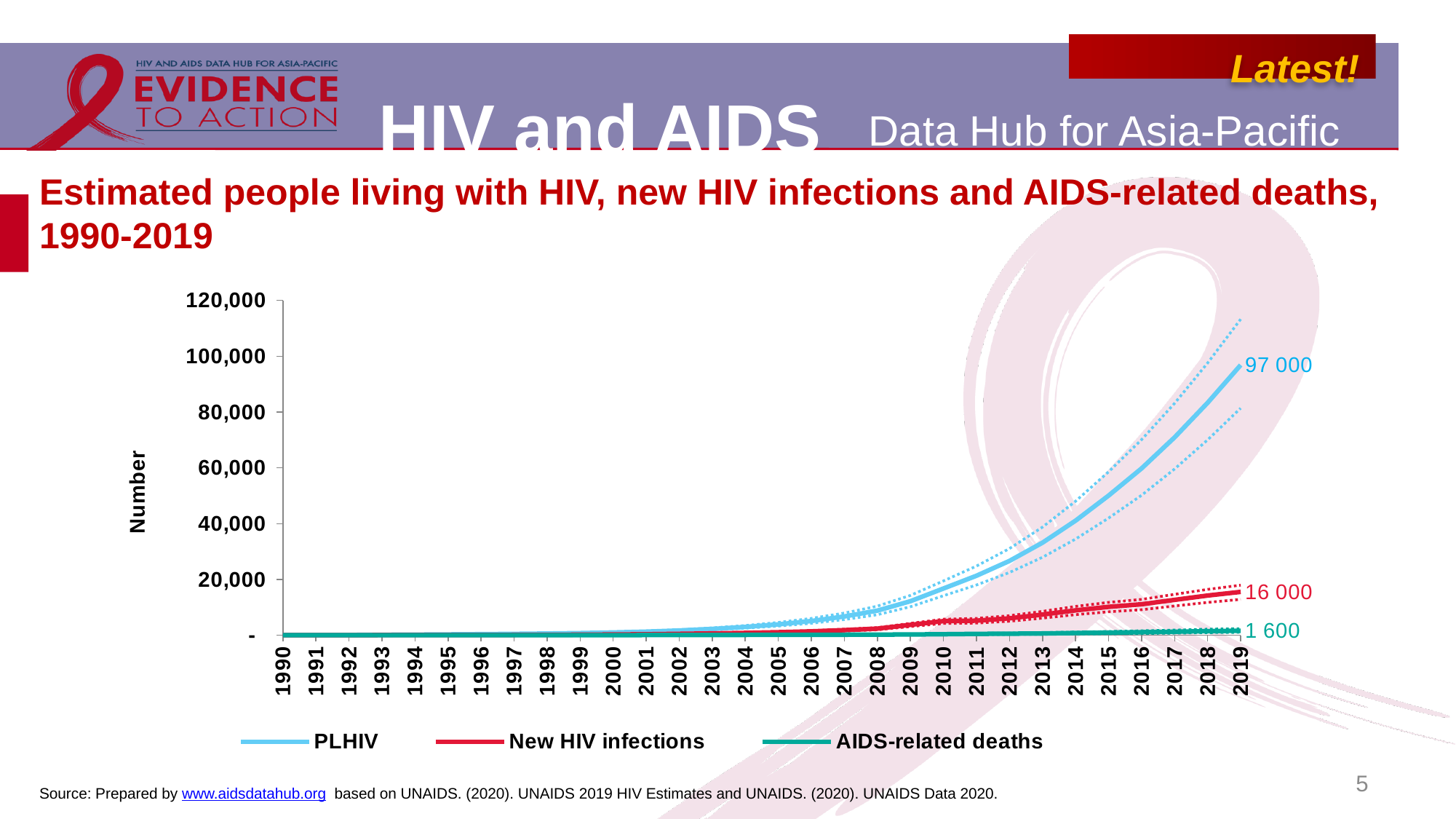
What is the value of New HIV infections in 2019? 16 000 How many series does the legend list? 3 Which series has the highest value in 2019? PLHIV Which is larger in 2019, New HIV infections or AIDS-related deaths? New HIV infections What is the label of the vertical axis? Number What kind of chart is shown on the slide? line chart What is the difference between PLHIV and New HIV infections in 2019? 81 000 Does the PLHIV line rise or fall from 1990 to 2019? rise Which series has the lowest value in 2019? AIDS-related deaths What is the value of PLHIV in 2019? 97 000 What is the value of AIDS-related deaths in 2019? 1 600 Is the value for PLHIV in 2015 greater or less than 80,000? less